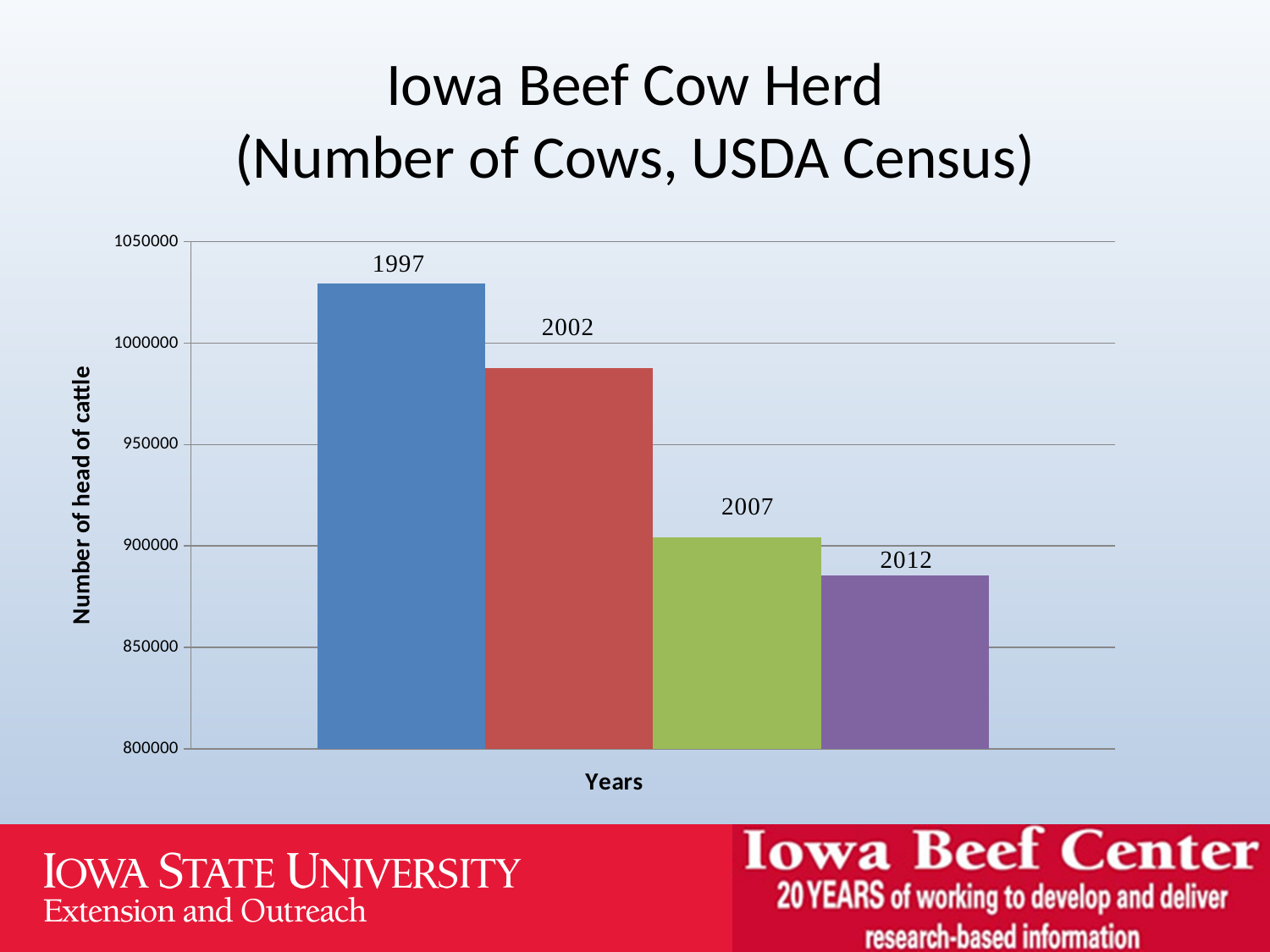
What is the label of the vertical axis? Number of head of cattle What kind of chart is shown on the slide? bar chart Which year has the lowest number of head of cattle? 2012 Is the value for 2012 greater or less than 850000? greater Which is larger, the value for 2002 or the value for 2007? 2002 Is the value for 2012 greater or less than 900000? less Which year has the highest number of head of cattle? 1997 Is the value for 2007 greater or less than 950000? less How many bars (years) are plotted in the chart? 4 Do the values rise or fall from 1997 to 2012? fall